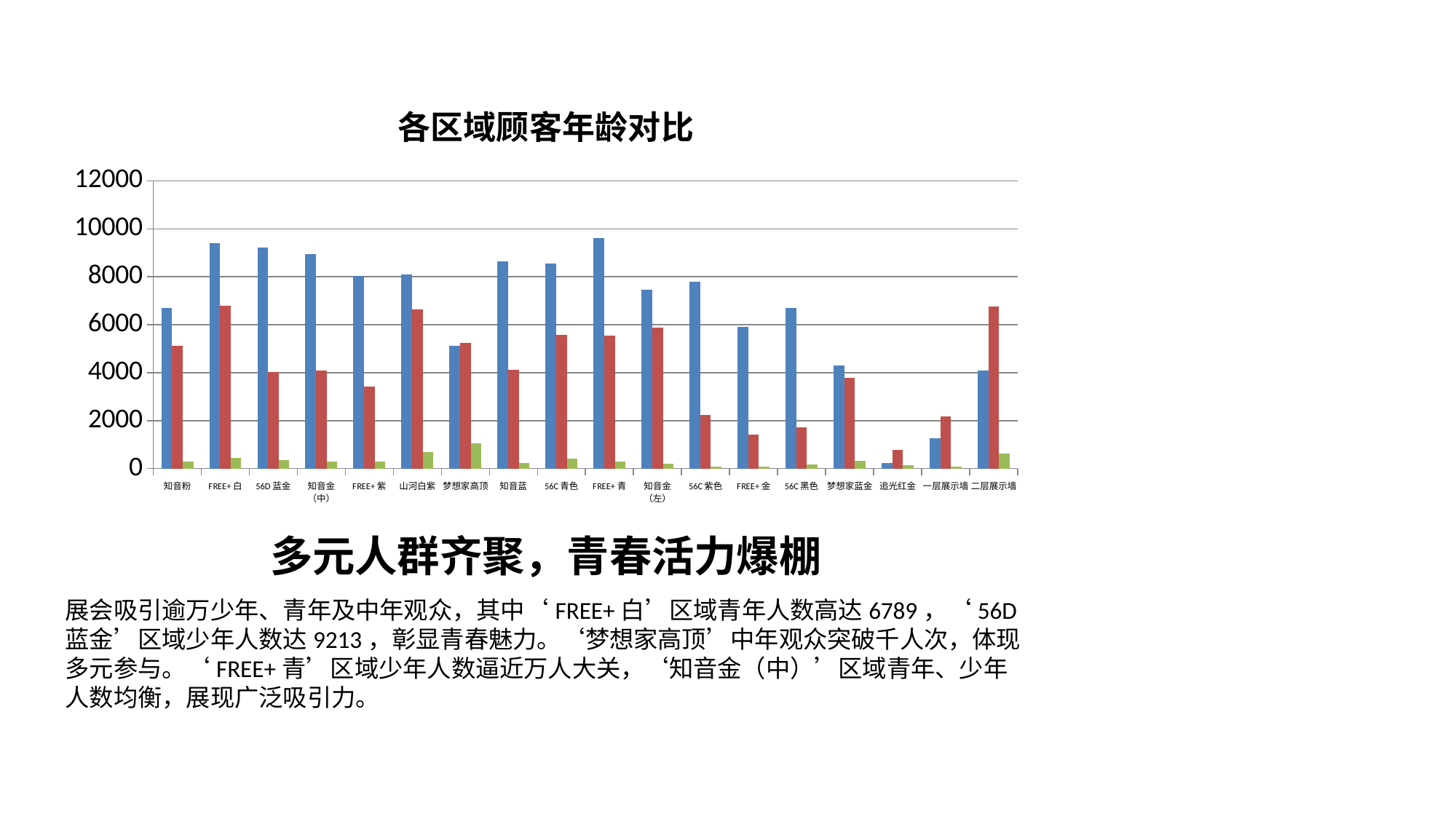
How many data series (bars per category) does the chart plot? 3 What is the title of the chart? 各区域顾客年龄对比 Which category has the lowest red bar? 追光红金 Which is larger, the red bar for 知音粉 or the red bar for 56C 紫色? 知音粉 Which category has the lowest blue bar? 追光红金 Is the blue bar for 追光红金 greater or less than 2000? less Is the red bar for FREE+ 紫 greater or less than 4000? less For 二层展示墙, which is larger, the blue bar or the red bar? the red bar Is the blue bar for FREE+ 青 greater or less than 8000? greater What kind of chart is shown on the slide? bar chart How many categories are shown along the x axis of the chart? 18